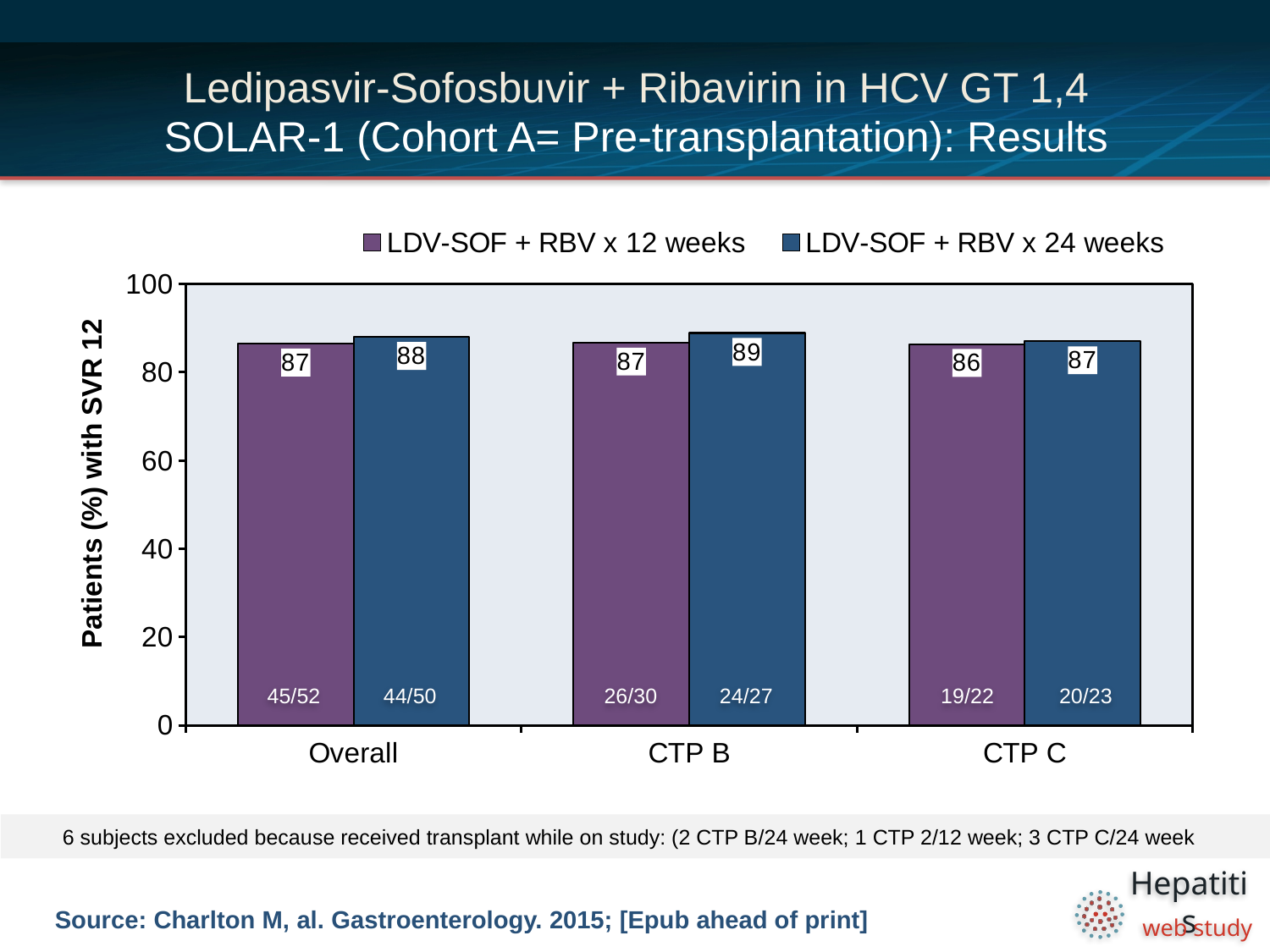
What is the difference between the 24-week and 12-week SVR 12 rates in the CTP B group? 2 What is the SVR 12 rate for the LDV-SOF + RBV x 12 weeks series in the Overall group? 87 Is the value for LDV-SOF + RBV x 12 weeks in the Overall group greater or less than 80? greater What is the SVR 12 rate for the LDV-SOF + RBV x 24 weeks series in the CTP B group? 89 Which category has the lowest value for the LDV-SOF + RBV x 12 weeks series? CTP C What fraction of patients is shown inside the LDV-SOF + RBV x 24 weeks bar for the Overall group? 44/50 What kind of chart is shown on the slide? Bar chart In the CTP C group, which series has the larger value, LDV-SOF + RBV x 12 weeks or LDV-SOF + RBV x 24 weeks? LDV-SOF + RBV x 24 weeks How many categories are shown on the x axis? 3 Which category has the highest value for the LDV-SOF + RBV x 24 weeks series? CTP B What is the SVR 12 rate for the LDV-SOF + RBV x 12 weeks series in the CTP C group? 86 How many series does the legend list? 2